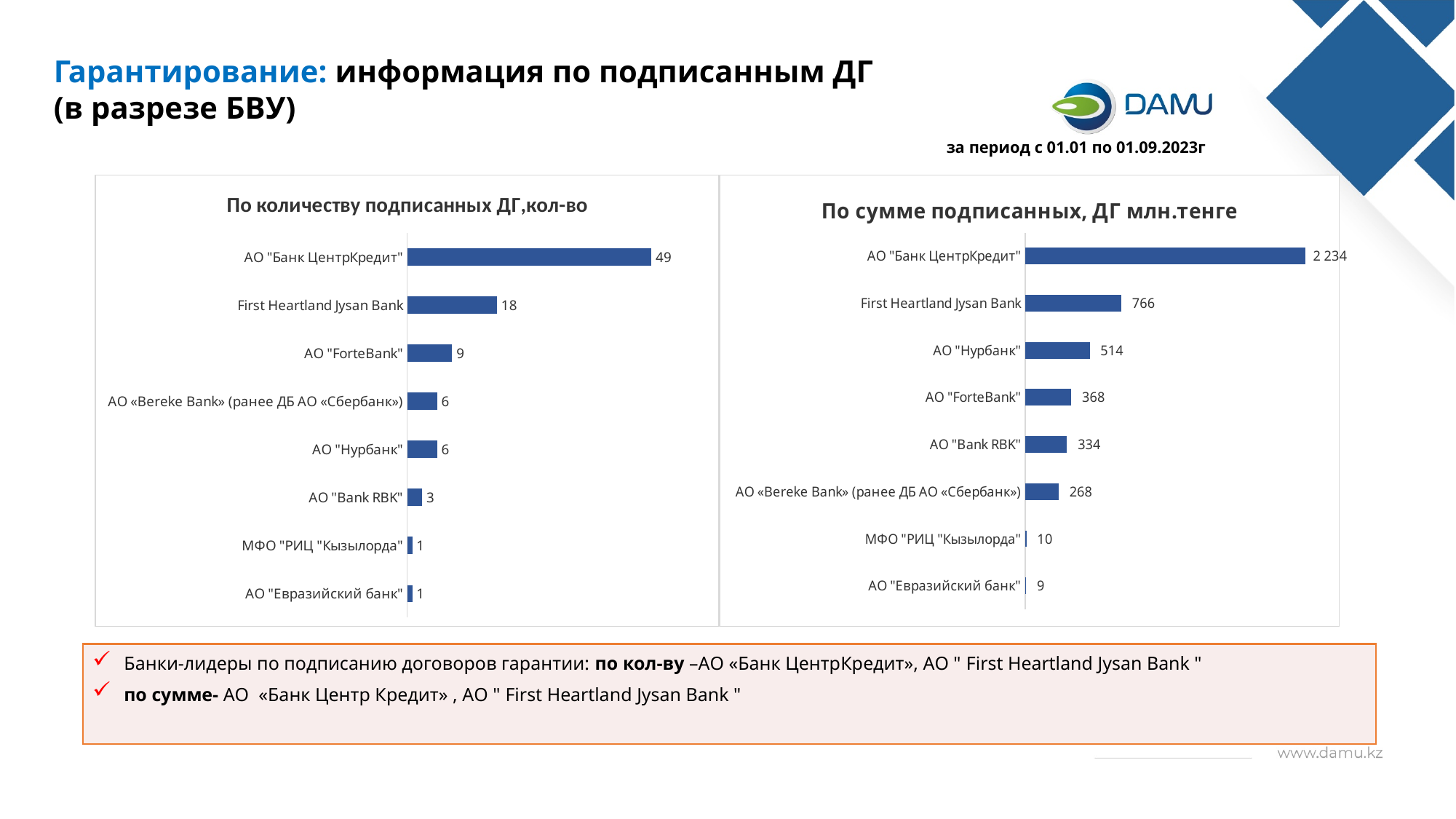
In the left chart 'По количеству подписанных ДГ,кол-во', what is the value for АО "ForteBank"? 9 In the left chart 'По количеству подписанных ДГ,кол-во', what is the value for АО "Банк ЦентрКредит"? 49 What is the title of the left chart on the slide? По количеству подписанных ДГ,кол-во In the right chart 'По сумме подписанных, ДГ млн.тенге', which bank has the lowest value? АО "Евразийский банк" In the right chart 'По сумме подписанных, ДГ млн.тенге', what is the difference between АО "Нурбанк" and АО "ForteBank"? 146 What type of chart is the right chart 'По сумме подписанных, ДГ млн.тенге'? Bar chart In the left chart 'По количеству подписанных ДГ,кол-во', what is the difference between АО "Банк ЦентрКредит" and First Heartland Jysan Bank? 31 How many banks are shown in the left chart 'По количеству подписанных ДГ,кол-во'? 8 In the right chart 'По сумме подписанных, ДГ млн.тенге', which bank has the highest value? АО "Банк ЦентрКредит" In the right chart 'По сумме подписанных, ДГ млн.тенге', what is the value for First Heartland Jysan Bank? 766 In the left chart 'По количеству подписанных ДГ,кол-во', which is larger: First Heartland Jysan Bank or АО "ForteBank"? First Heartland Jysan Bank In the right chart 'По сумме подписанных, ДГ млн.тенге', what is the value for АО "Bank RBK"? 334